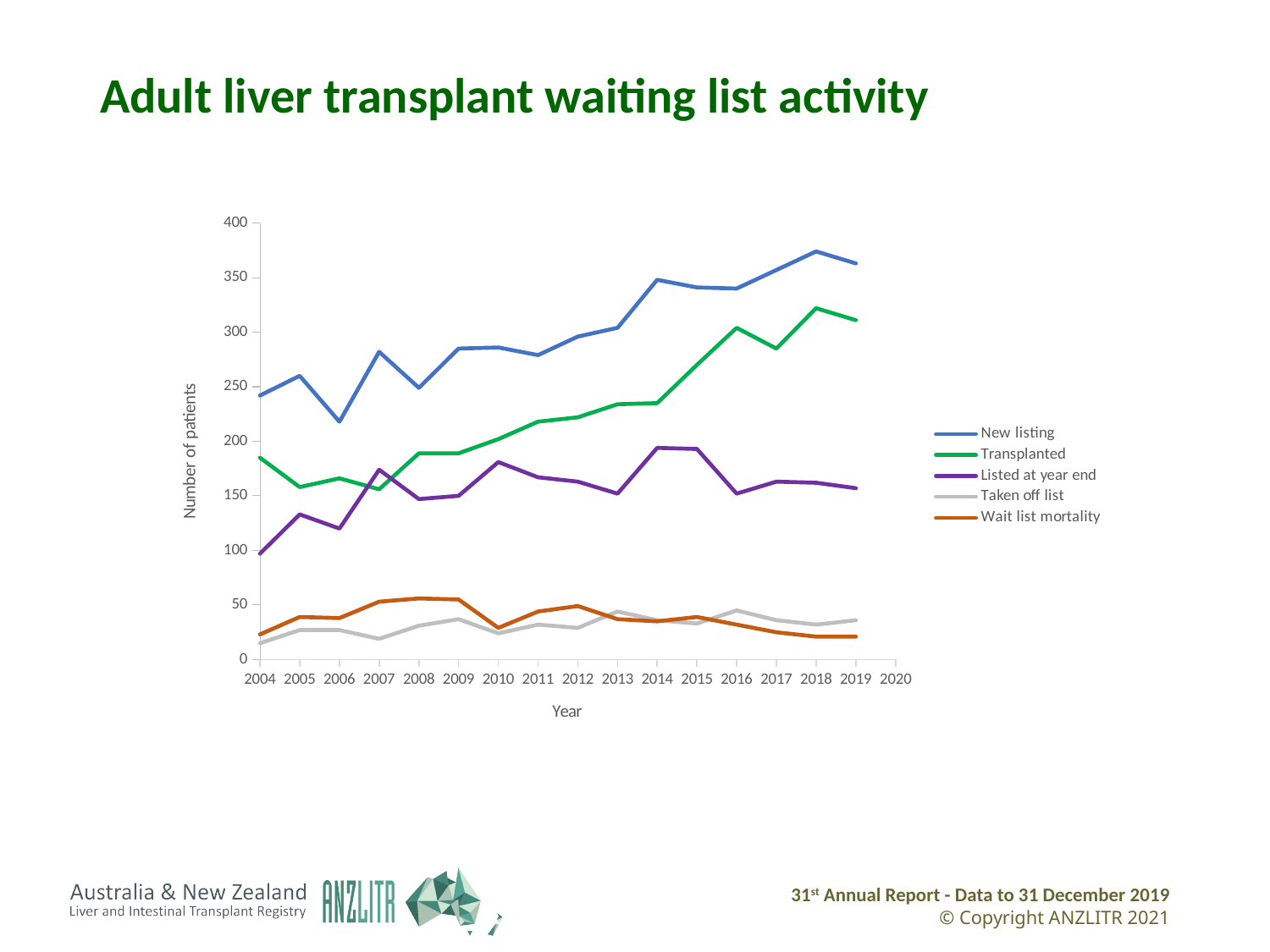
What is the label on the vertical axis? Number of patients Does the Transplanted series rise or fall between 2010 and 2016? rise What kind of chart is shown on the slide? line chart Is the value for Transplanted in 2004 greater or less than 200? less Which series has the lowest value in 2004? Taken off list What is the title of the chart? Adult liver transplant waiting list activity Is the value for Wait list mortality in 2019 greater or less than 50? less Is the value for New listing in 2018 greater or less than 350? greater In which year does the New listing series reach its highest value? 2018 In which year does the New listing series reach its lowest value? 2006 In 2019, which is larger: New listing or Transplanted? New listing How many series does the legend list? 5